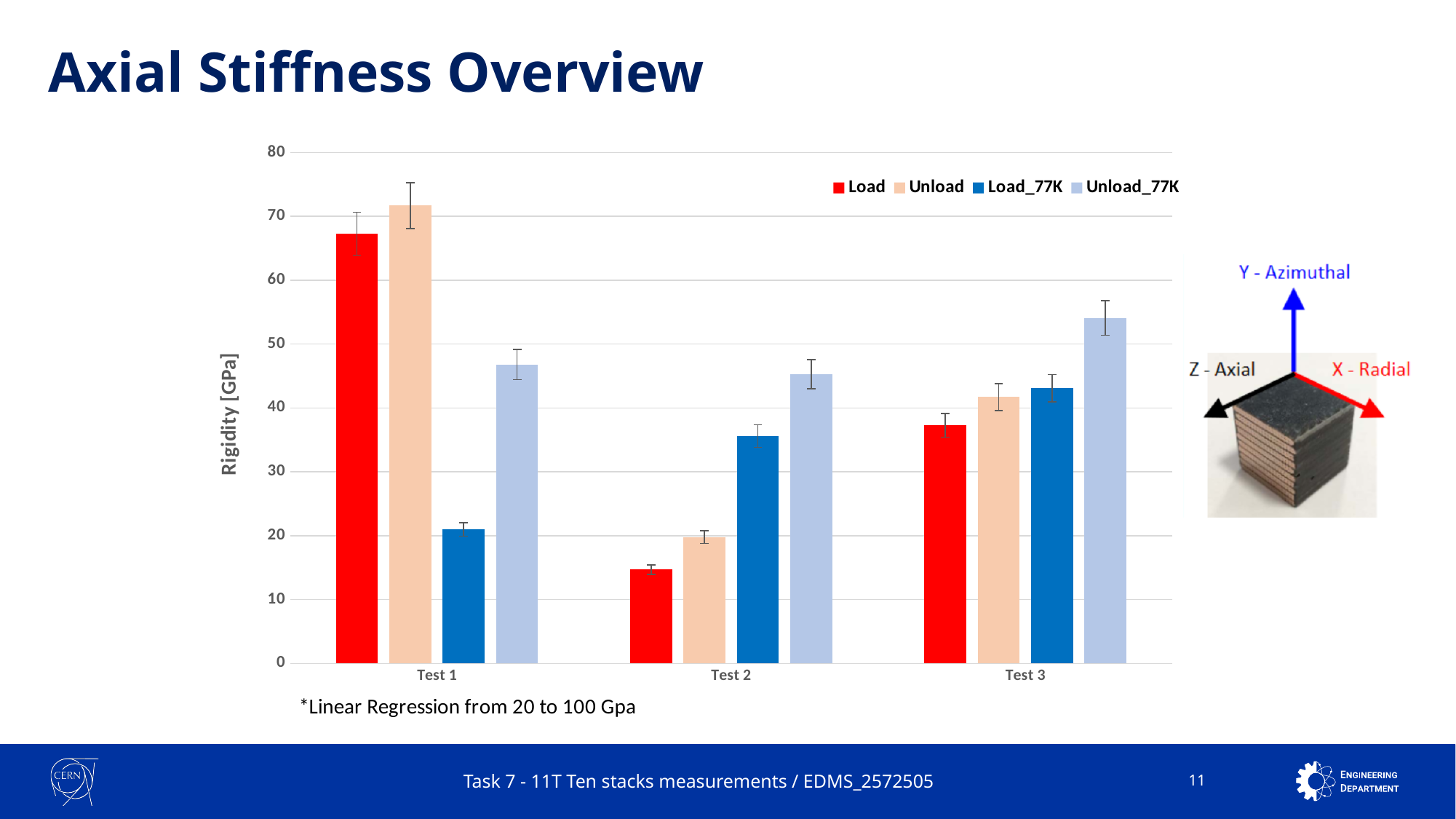
What is the label of the vertical axis? Rigidity [GPa] Which test has the highest Load value? Test 1 Is the Load value for Test 2 greater or less than 20? less Is the Unload value for Test 1 greater or less than 70? greater What kind of chart is shown on the slide? bar chart How many series does the chart legend list? 4 For Test 1, which is larger: the Unload value or the Unload_77K value? Unload Which test has the highest Unload_77K value? Test 3 Which test has the lowest Load value? Test 2 Is the Load_77K value for Test 1 greater or less than 30? less How many test categories are shown on the x axis? 3 For Test 2, which is larger: the Load_77K value or the Load value? Load_77K